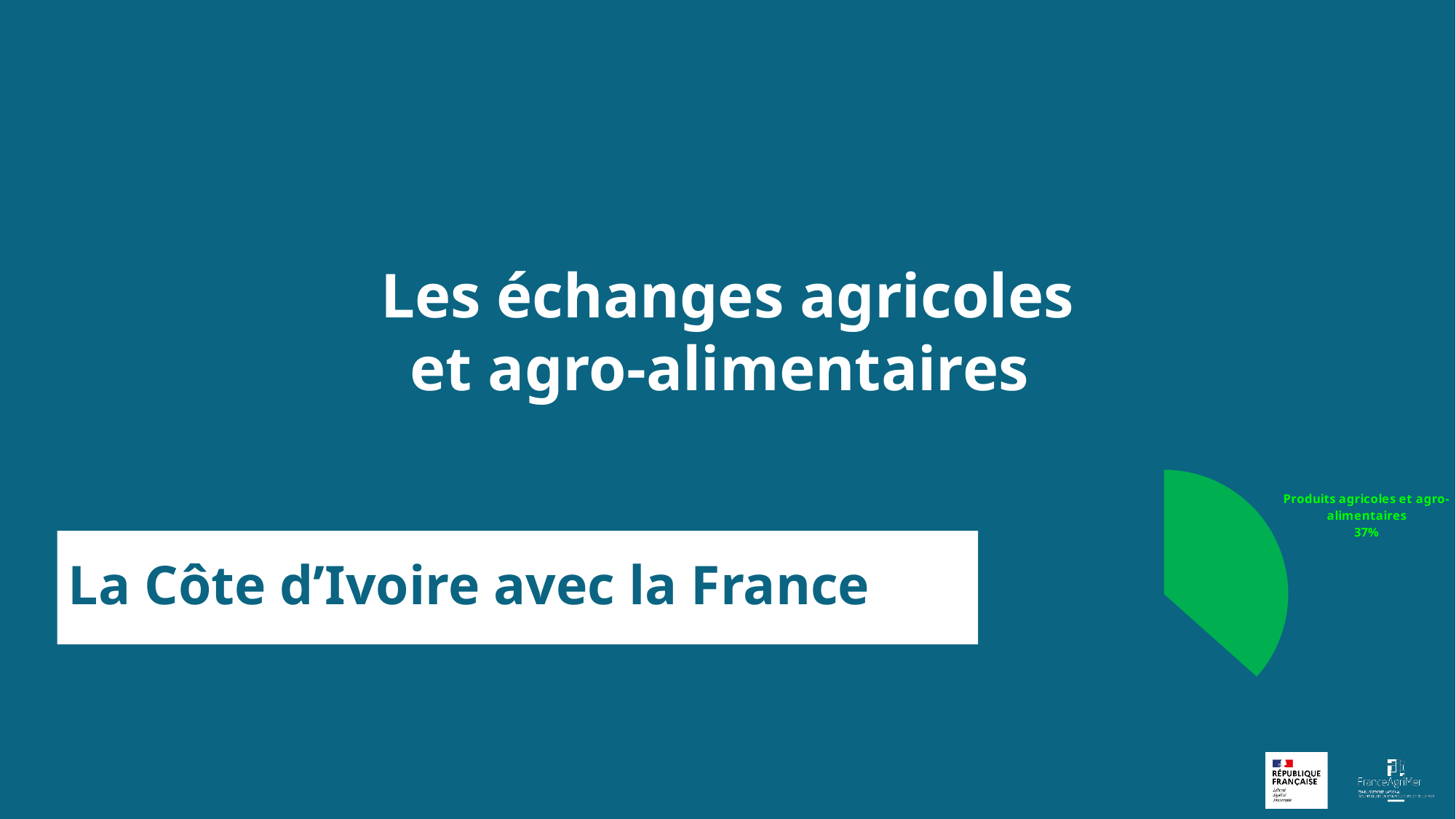
What is the label of the green slice in the pie chart? Produits agricoles et agro-alimentaires What kind of chart is shown on the slide? pie chart What colour is the labelled slice of the pie chart? green What share of the pie does the slice labelled "Produits agricoles et agro-alimentaires" represent? 37% What value is printed for the "Produits agricoles et agro-alimentaires" slice? 37% How many slices of the pie chart are labelled? 1